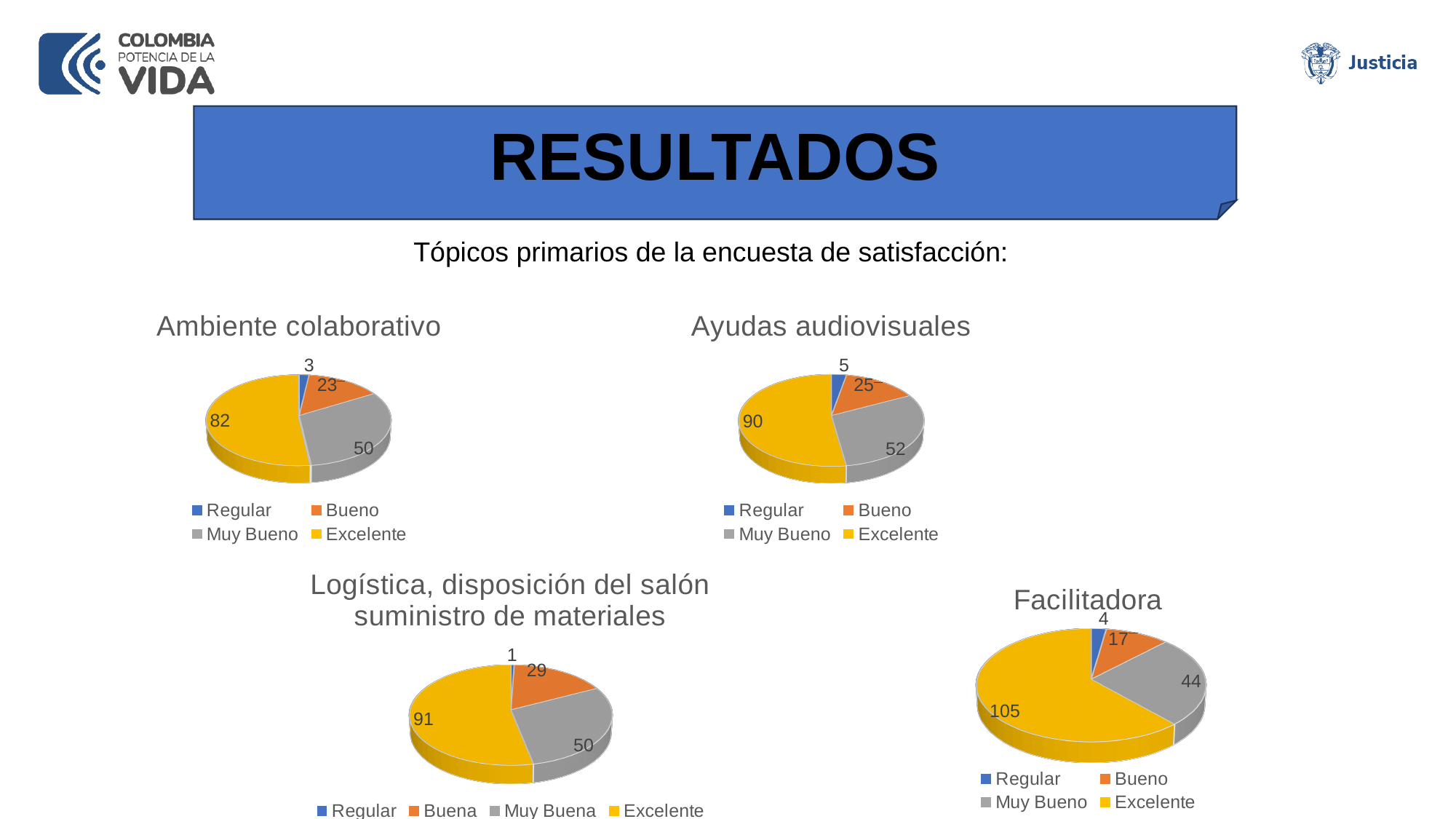
In the 'Logística, disposición del salón suministro de materiales' chart, what is the value for Regular? 1 In the 'Ambiente colaborativo' chart, what is the value for Excelente? 82 How many charts are shown on the slide? 4 How many slices does the 'Facilitadora' pie chart have? 4 In the 'Facilitadora' chart, which category has the largest slice? Excelente In the 'Facilitadora' chart, what is the value for Bueno? 17 In the 'Ayudas audiovisuales' chart, what is the value for Muy Bueno? 52 What kind of chart is 'Ayudas audiovisuales'? Pie chart In the 'Logística, disposición del salón suministro de materiales' chart, which is larger, Buena or Muy Buena? Muy Buena In the 'Ambiente colaborativo' chart, what is the difference between the Excelente and Muy Bueno values? 32 What is the total of all slices in the 'Facilitadora' chart? 170 In the 'Ayudas audiovisuales' chart, which category has the smallest slice? Regular